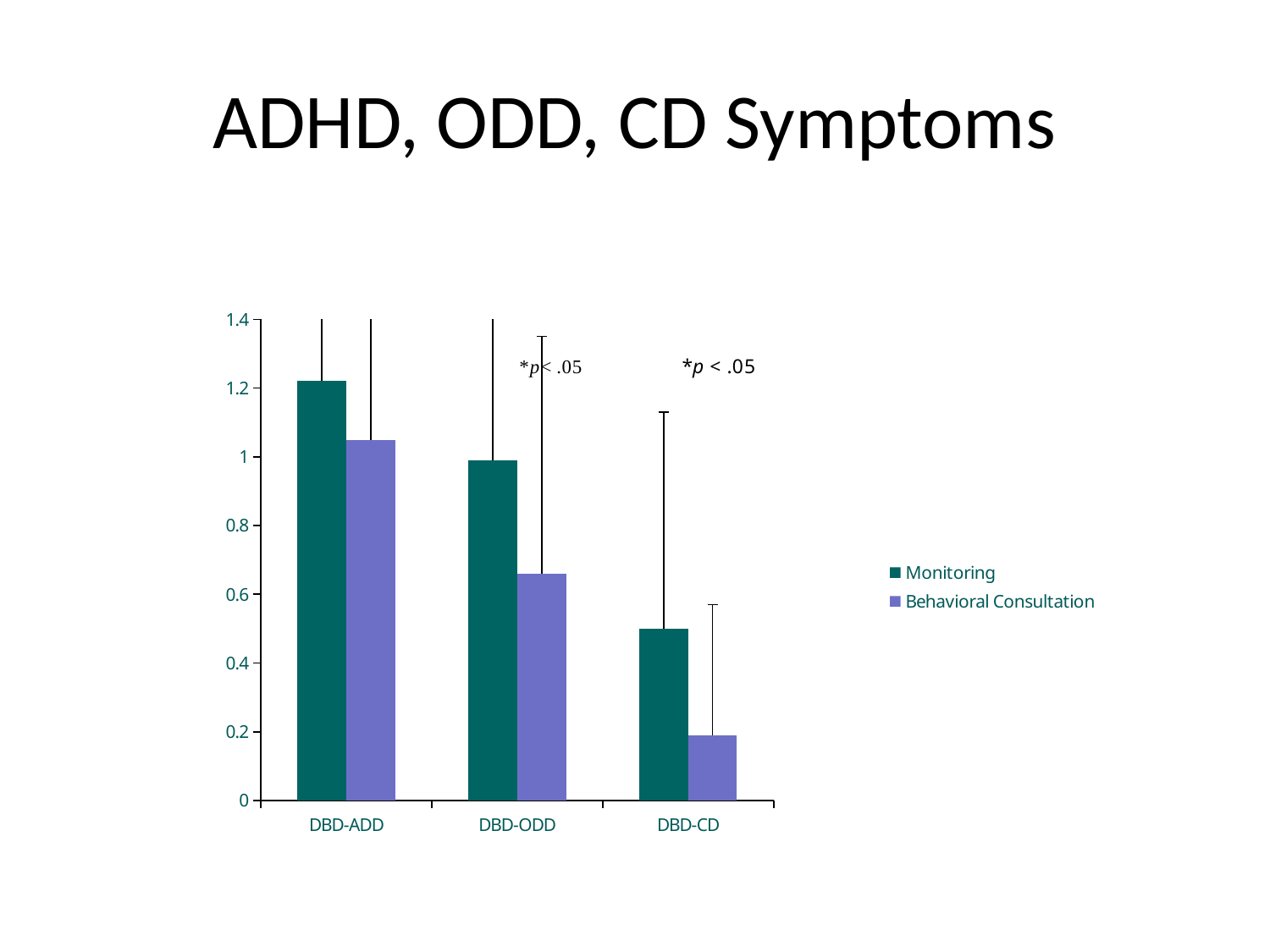
Is the Behavioral Consultation value for DBD-ODD greater or less than 0.8? less Which category has the highest Monitoring value? DBD-ADD What kind of chart is shown on the slide? bar chart Is the Behavioral Consultation value for DBD-CD greater or less than 0.4? less How many categories are shown on the x axis? 3 Do the Monitoring values rise or fall from DBD-ADD to DBD-CD? fall Is the Monitoring value for DBD-ADD greater or less than 1? greater Which category has the lowest Behavioral Consultation value? DBD-CD Which series is shown in purple? Behavioral Consultation What is the title of the slide? ADHD, ODD, CD Symptoms For DBD-ODD, which series has the larger value, Monitoring or Behavioral Consultation? Monitoring How many series does the legend list? 2